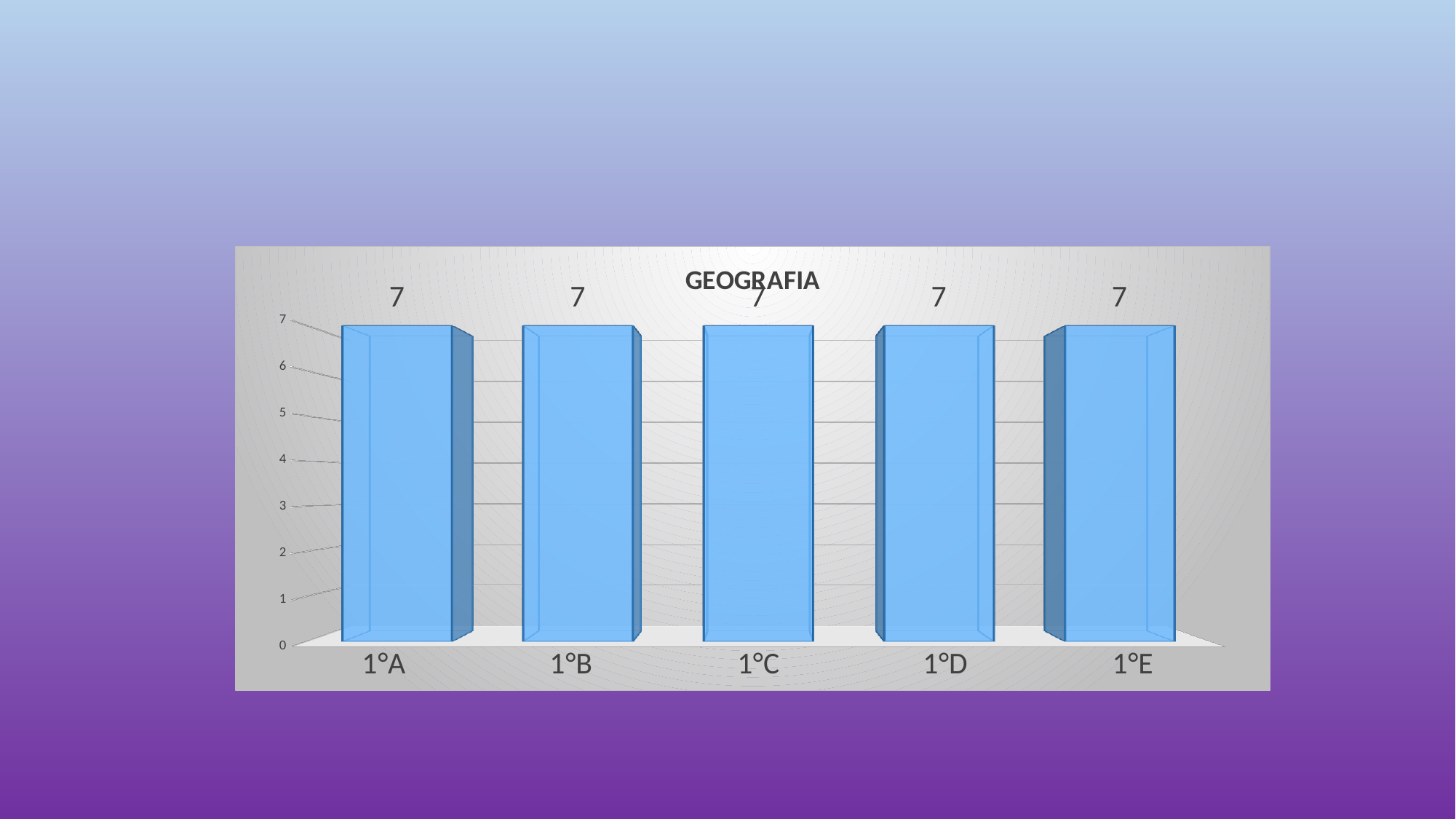
Is the value for 1°E greater or less than 3? greater How many categories are shown on the x axis? 5 What is the value for 1°D? 7 What is the highest value shown on the vertical axis? 7 What is the value for 1°E? 7 What is the value for 1°C? 7 What is the value for 1°A? 7 Is the value for 1°B greater or less than 5? greater What is the title of the chart? GEOGRAFIA What kind of chart is shown on the slide? Bar chart What is the difference between the values for 1°A and 1°B? 0 Do the values rise, fall, or stay the same from 1°A to 1°E? Stay the same